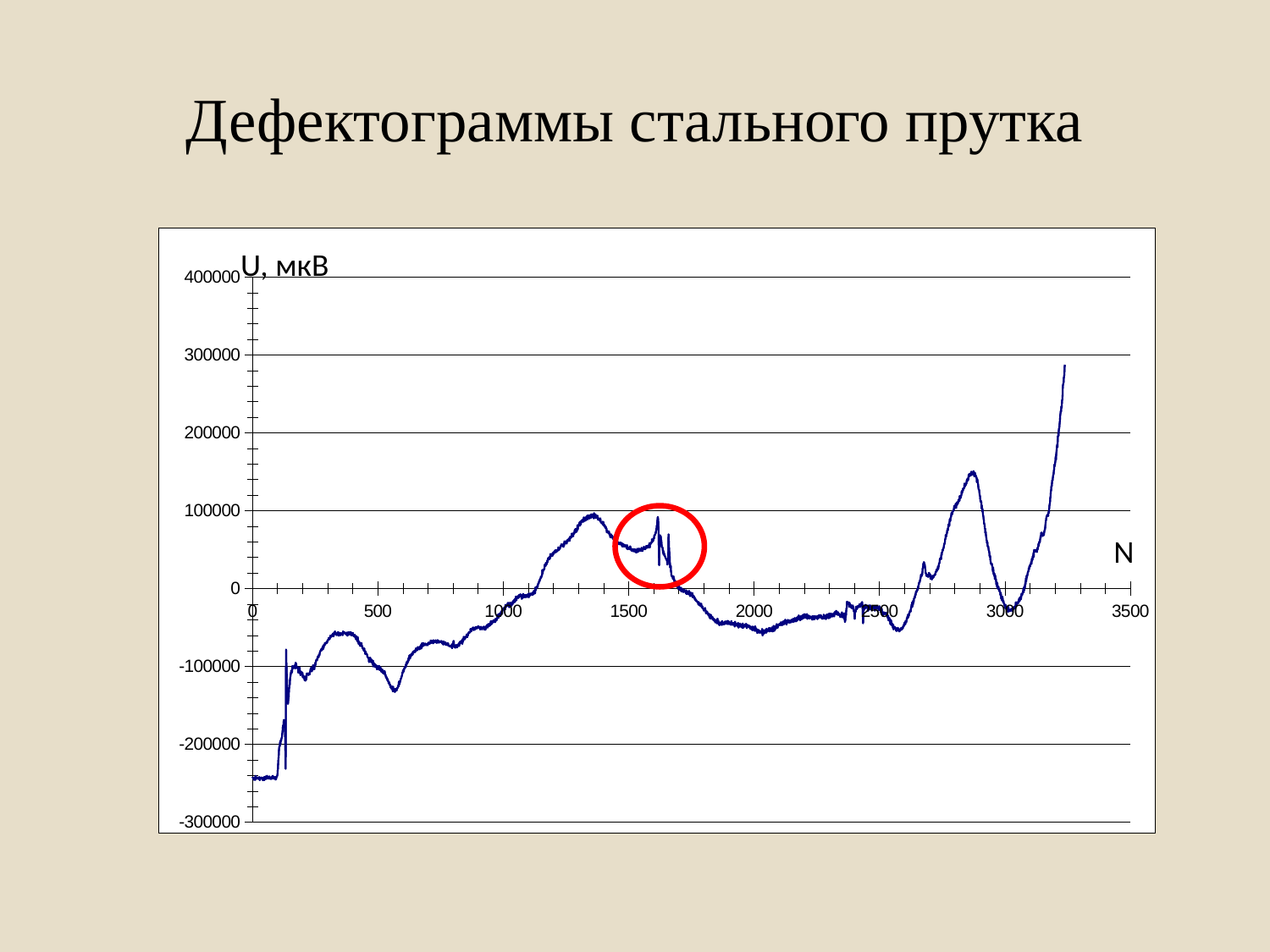
Is the peak value of U near N = 2900 greater or less than 100000? greater Is the value of U at the right end of the curve (around N = 3200) larger or smaller than the value at N = 0? larger Do the values of U rise or fall as N goes from 0 to 500? rise Is the value of U at N = 1500 greater or less than 0? greater Is the value of U at N = 1300 greater or less than 100000? less What label is shown on the vertical axis of the chart? U, мкВ What kind of chart is shown on the slide? line chart Do the values of U rise or fall as N goes from 2900 to 3000? fall What is the title of the slide above the chart? Дефектограммы стального прутка